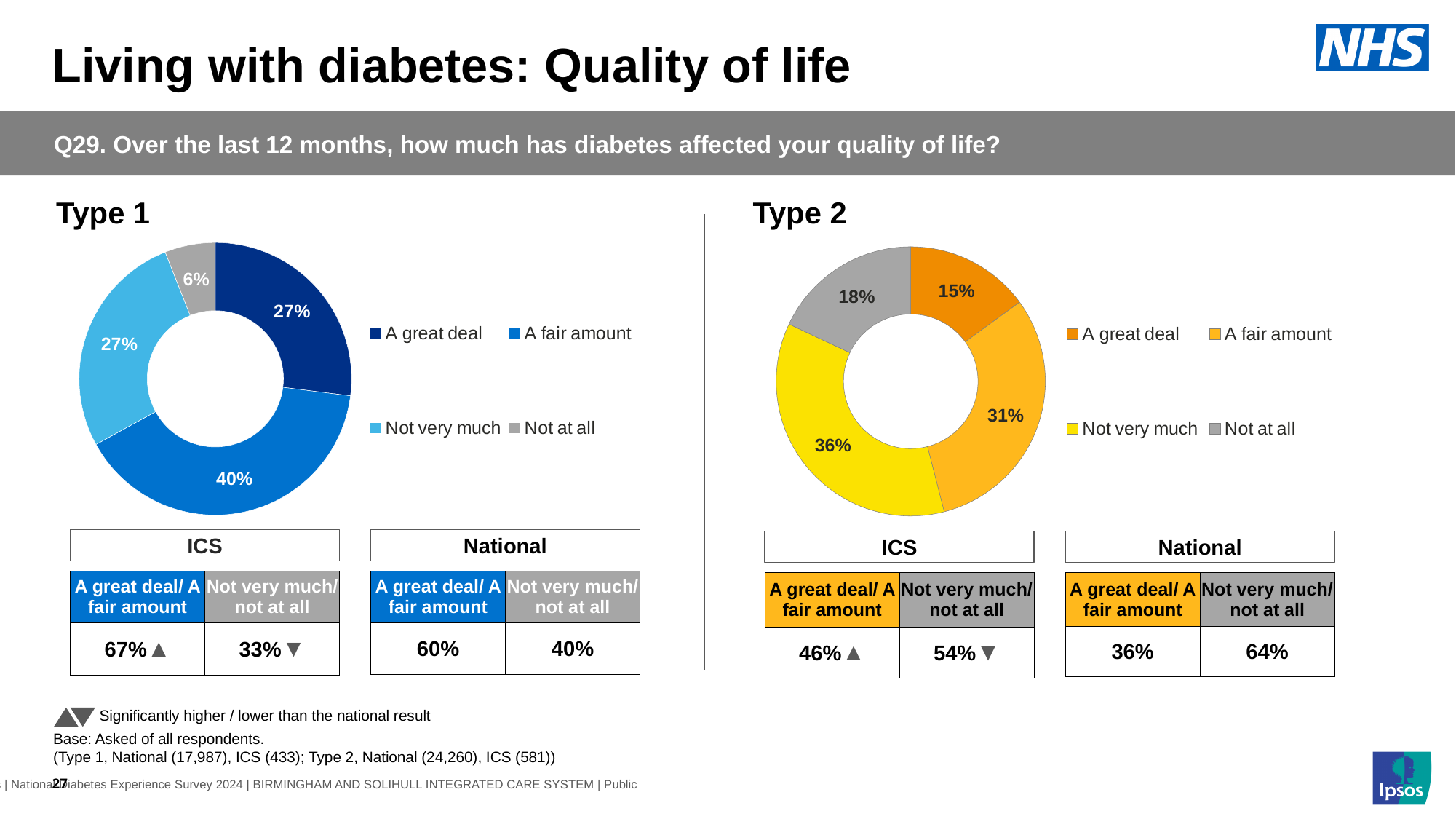
In the Type 1 chart, which is larger: 'A great deal' or 'Not at all'? A great deal How many categories does the legend of the Type 1 chart list? 4 In the Type 1 chart, what percentage said 'Not at all'? 6% In the Type 2 chart, which is larger: 'A fair amount' or 'Not very much'? Not very much What kind of chart is used for Type 2? Donut (pie) chart In the Type 1 chart, what percentage of respondents said diabetes affected their quality of life 'A fair amount'? 40% In the Type 2 chart, which response has the smallest share? A great deal In the Type 2 chart, what percentage said 'A great deal'? 15% What is the combined share of 'A great deal' and 'A fair amount' in the Type 1 chart? 67% In the Type 1 chart, which response has the largest share? A fair amount In the Type 2 chart, what is the difference in percentage points between 'Not very much' and 'Not at all'? 18 In the Type 2 chart, what percentage said 'Not very much'? 36%